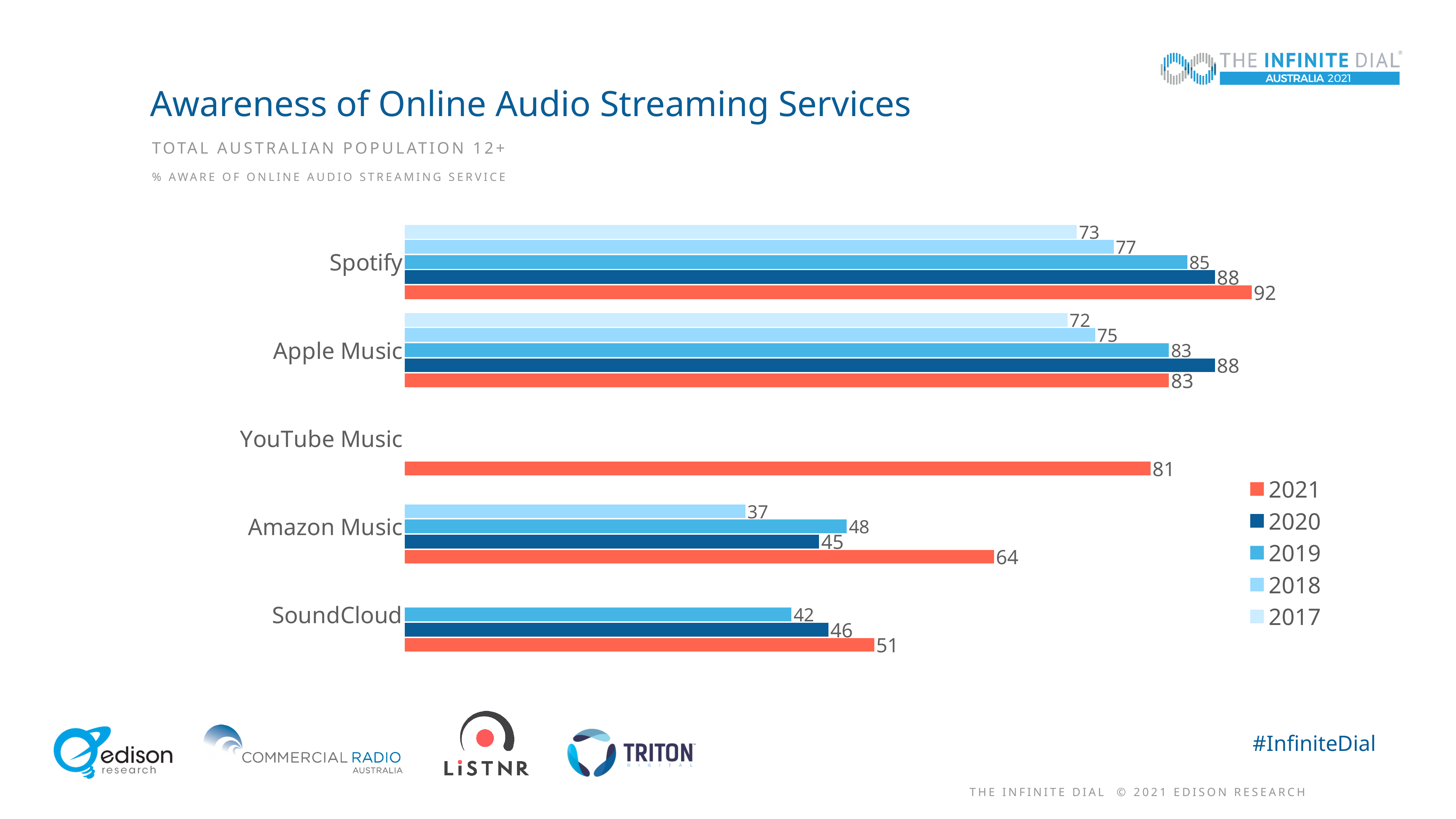
What kind of chart is shown on the slide? Bar chart How many streaming services are listed on the chart? 5 How many series does the legend list? 5 Which service has the highest 2021 awareness value? Spotify What is the 2021 awareness value for Spotify? 92 Which is larger for Apple Music: the 2020 value or the 2021 value? 2020 What is the 2021 awareness value for YouTube Music? 81 What is the 2018 awareness value for Amazon Music? 37 What is the difference between the 2021 and 2020 awareness values for Amazon Music? 19 What is the 2017 awareness value for Apple Music? 72 Which service has the lowest 2021 awareness value? SoundCloud Did Spotify's awareness rise or fall from 2017 to 2021? Rise